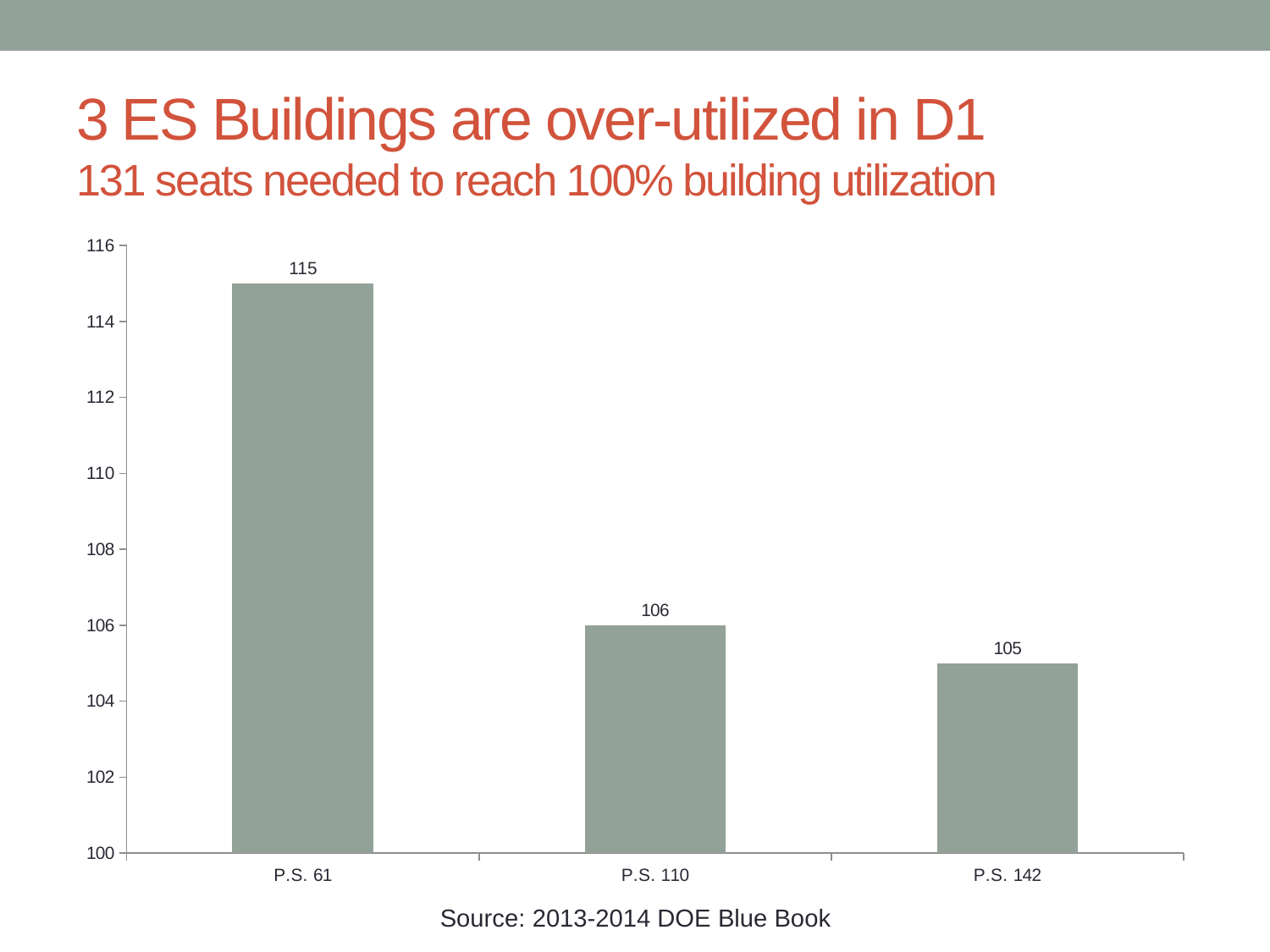
Which is larger, the value for P.S. 61 or the value for P.S. 142? P.S. 61 What is the value for P.S. 61? 115 What is the difference between the values for P.S. 61 and P.S. 110? 9 Which building has the highest value? P.S. 61 How many buildings are shown in the chart? 3 Is the value for P.S. 110 greater or less than 110? less What is the difference between the values for P.S. 110 and P.S. 142? 1 What source is cited below the chart? 2013-2014 DOE Blue Book What is the value for P.S. 142? 105 What is the value for P.S. 110? 106 What kind of chart is shown on the slide? bar chart Which building has the lowest value? P.S. 142